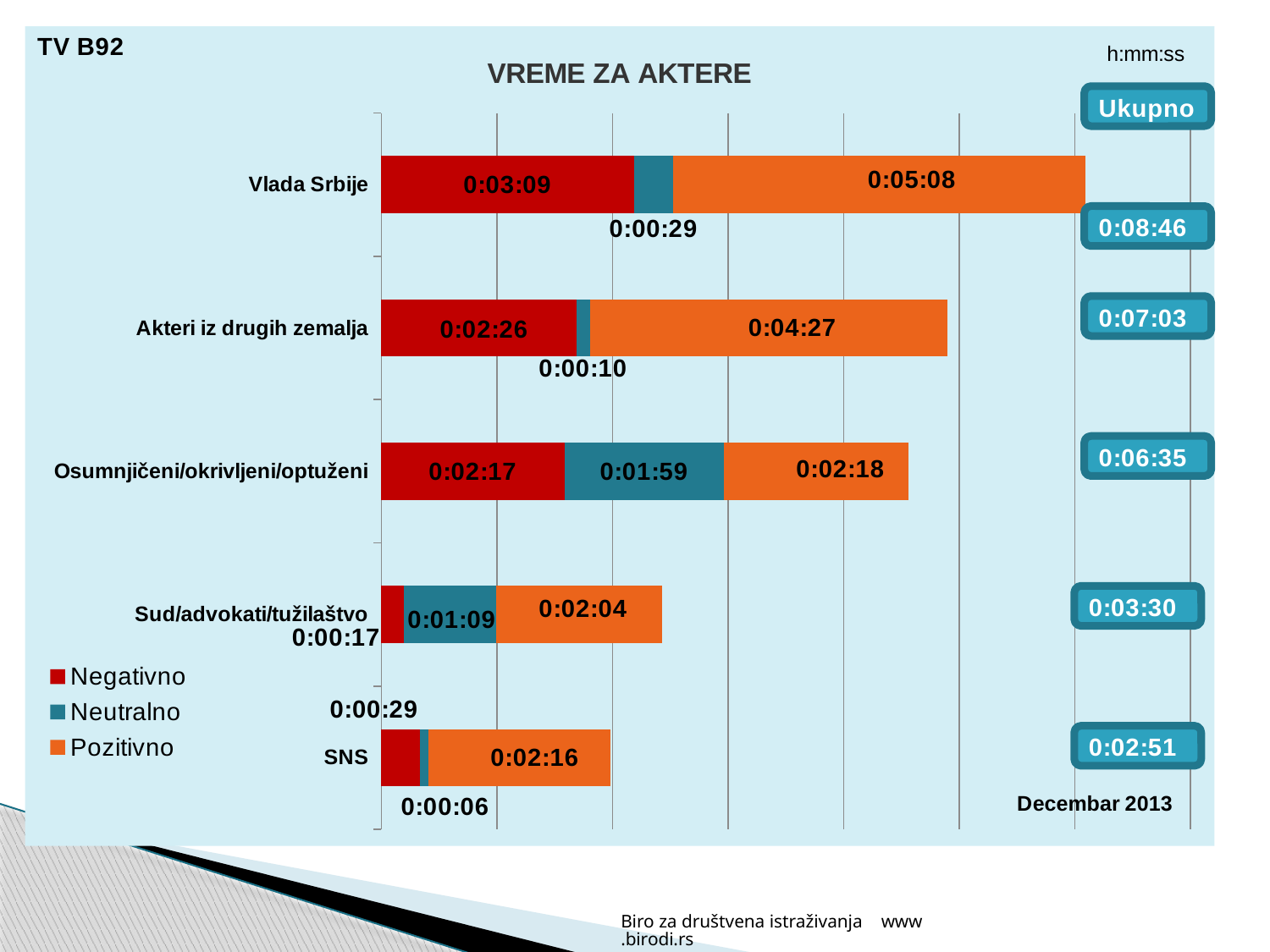
What is the title of the chart? VREME ZA AKTERE What is the Negativno value for Akteri iz drugih zemalja? 0:02:26 What is the Pozitivno value for Vlada Srbije? 0:05:08 What kind of chart is shown on the slide? Stacked bar chart Is the Pozitivno value for Akteri iz drugih zemalja larger or smaller than the Pozitivno value for Sud/advokati/tužilaštvo? Larger What is the total (Ukupno) time for SNS? 0:02:51 Which category has the largest Neutralno value? Osumnjičeni/okrivljeni/optuženi What is the Neutralno value for Osumnjičeni/okrivljeni/optuženi? 0:01:59 How many series does the legend list? 3 Which category has the lowest total (Ukupno) time? SNS How many categories (actors) are plotted in the chart? 5 Which category has the highest total (Ukupno) time? Vlada Srbije